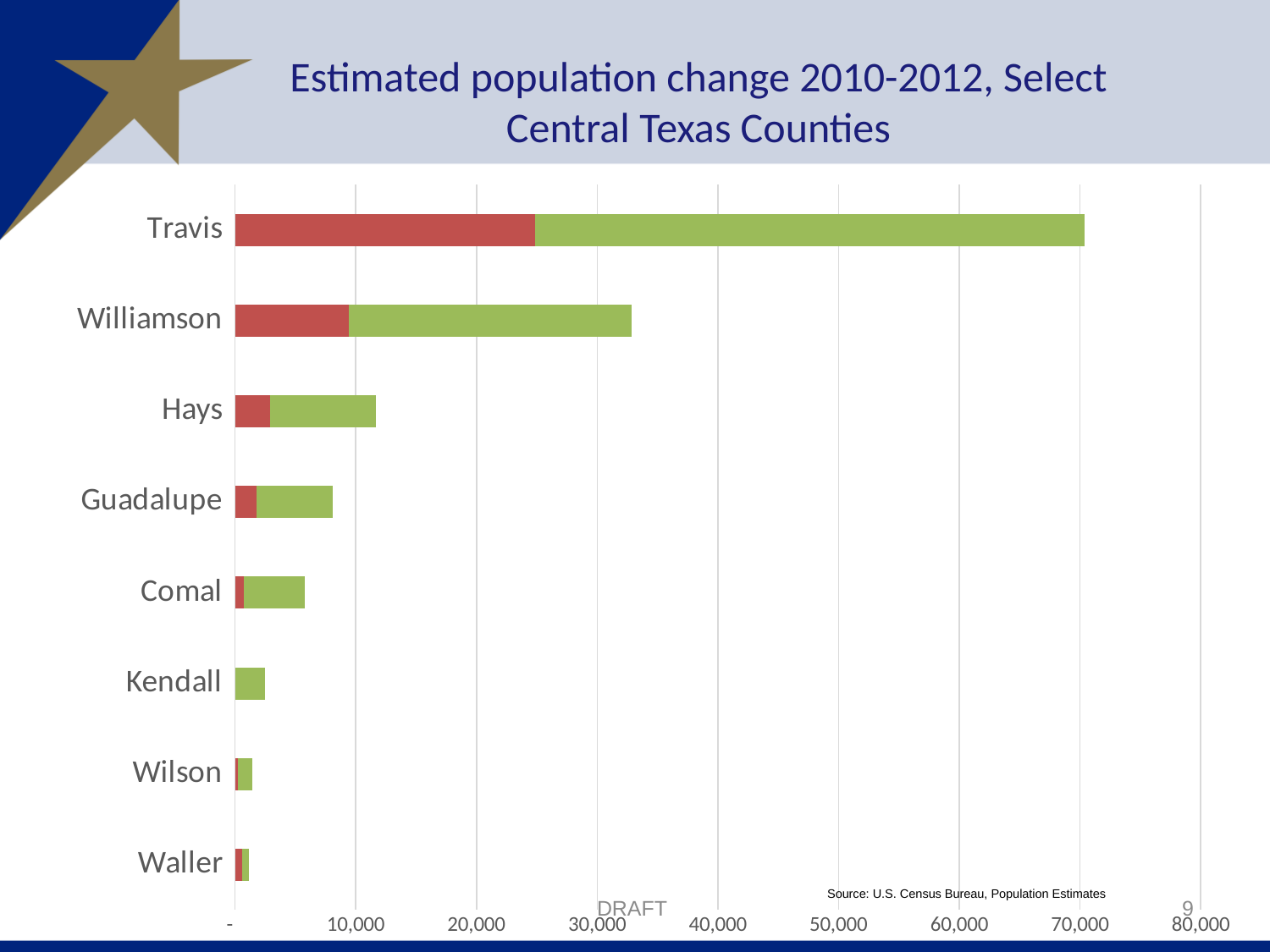
Do the bars get longer or shorter going from Travis at the top to Waller at the bottom? shorter Which county has the longest bar (largest estimated population change)? Travis Which county has a larger total bar, Kendall or Comal? Comal What kind of chart is shown on the slide? Stacked bar chart Is the total bar for Williamson greater or less than 40,000? less Which county has the shortest bar (smallest estimated population change)? Waller What is the title of the chart? Estimated population change 2010-2012, Select Central Texas Counties How many counties are shown on the chart? 8 Is the total bar for Hays greater or less than 10,000? greater Is the total bar for Travis greater or less than 60,000? greater Which county has a larger total bar, Williamson or Hays? Williamson